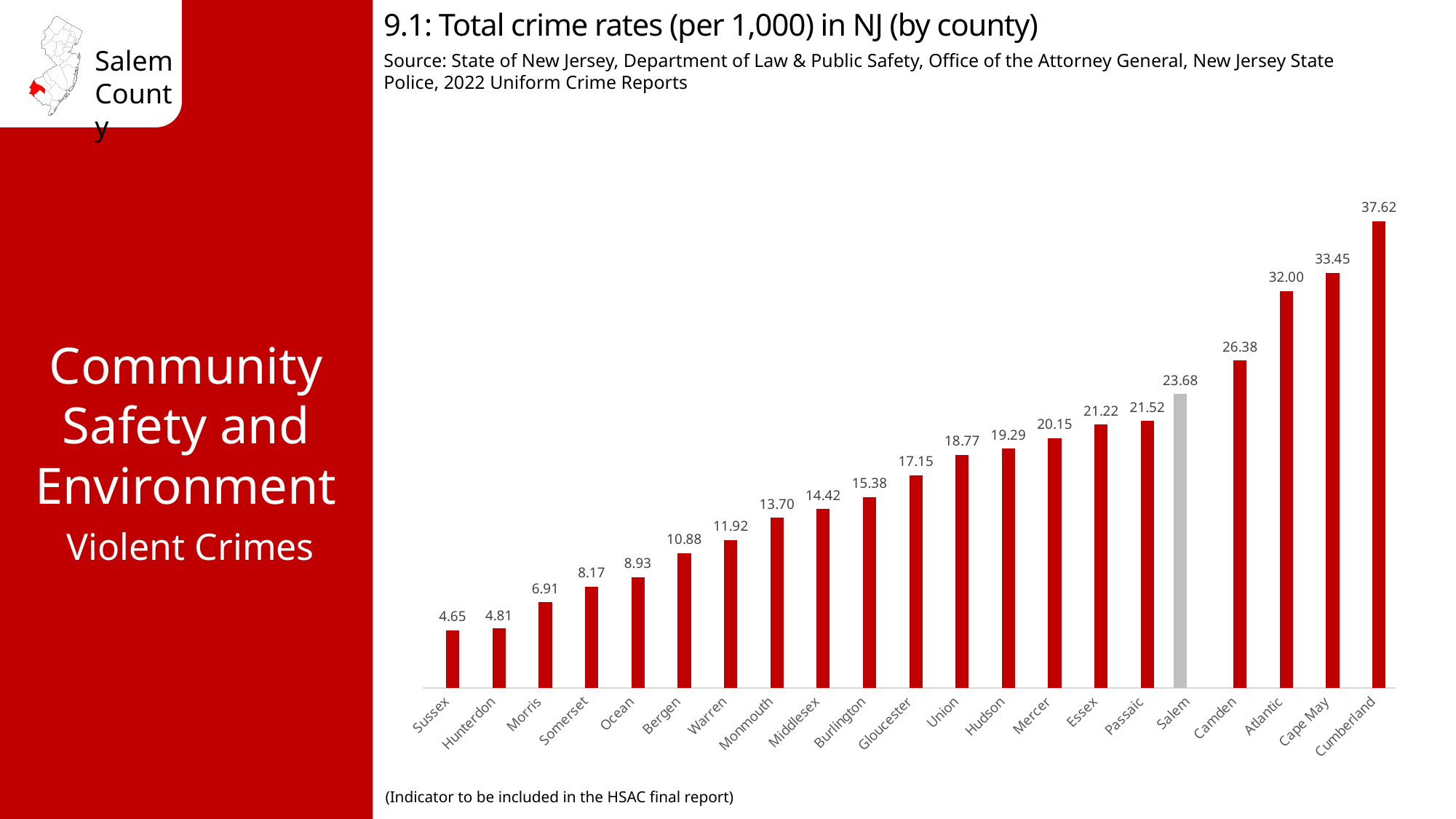
What is the total crime rate (per 1,000) for Salem County? 23.68 Which county has the highest total crime rate? Cumberland What is the total crime rate (per 1,000) for Gloucester County? 17.15 What is the total crime rate (per 1,000) for Bergen County? 10.88 Which county has a higher total crime rate, Camden or Salem? Camden Which county has the lowest total crime rate? Sussex What kind of chart is used to show the total crime rates by county? Bar chart Which county has a higher total crime rate, Morris or Ocean? Ocean How many counties are shown in the chart? 21 Which county's bar is shown in grey rather than red? Salem What is the difference between the total crime rates of Salem and Passaic? 2.16 What is the difference between the total crime rates of Cumberland and Sussex? 32.97